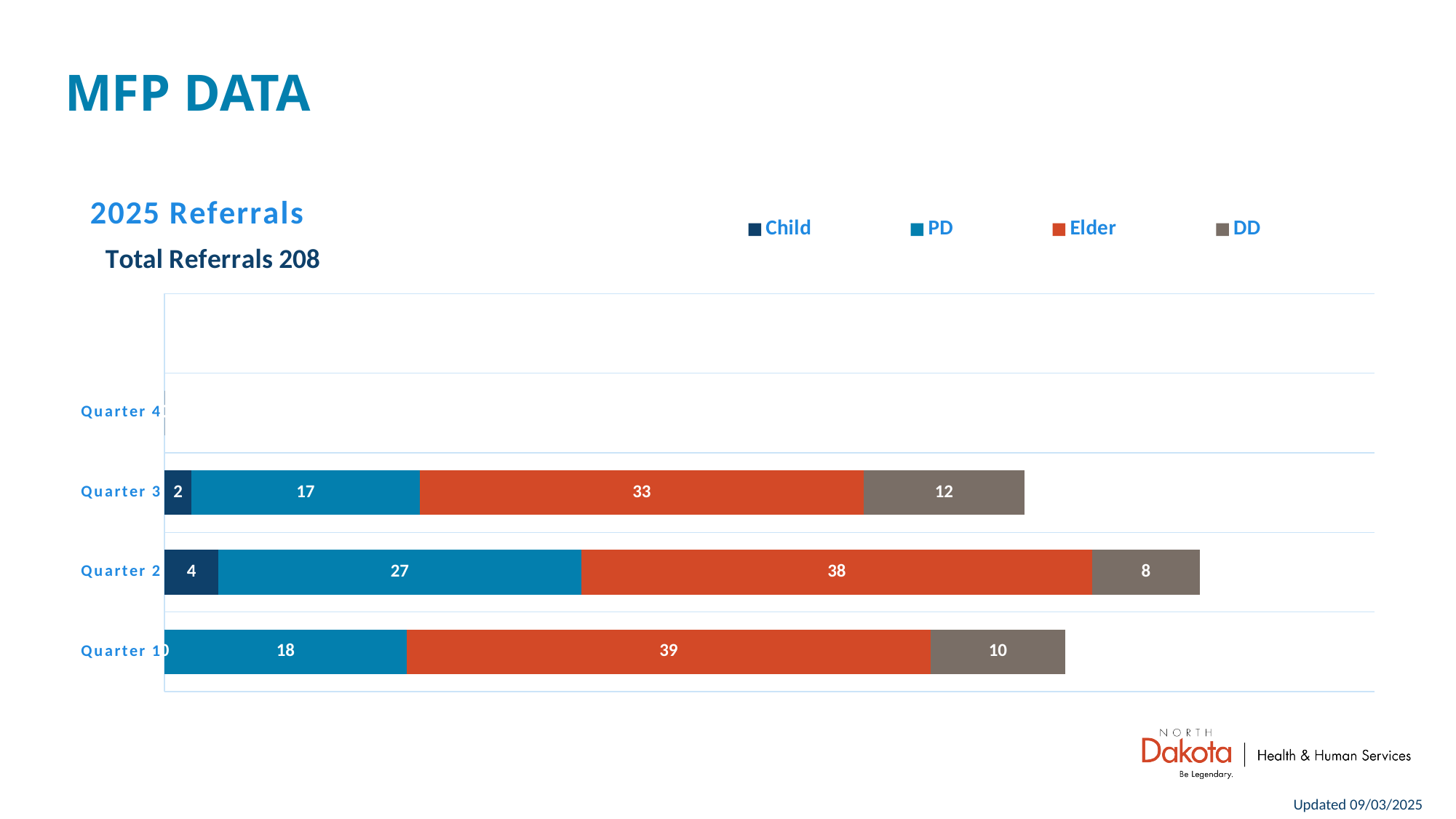
What is the Elder value for Quarter 2? 38 What is the PD value for Quarter 3? 17 What total number of referrals is stated on the slide? 208 Is the DD value larger for Quarter 3 or Quarter 2? Quarter 3 What is the total of the stacked bar for Quarter 2? 77 Which quarter has the highest Elder value? Quarter 1 How many series does the legend list? 4 Which quarter has the lowest PD value? Quarter 3 What is the Child value for Quarter 2? 4 What kind of chart is shown on the slide? Stacked bar chart What is the difference between the PD values for Quarter 2 and Quarter 1? 9 What is the DD value for Quarter 1? 10